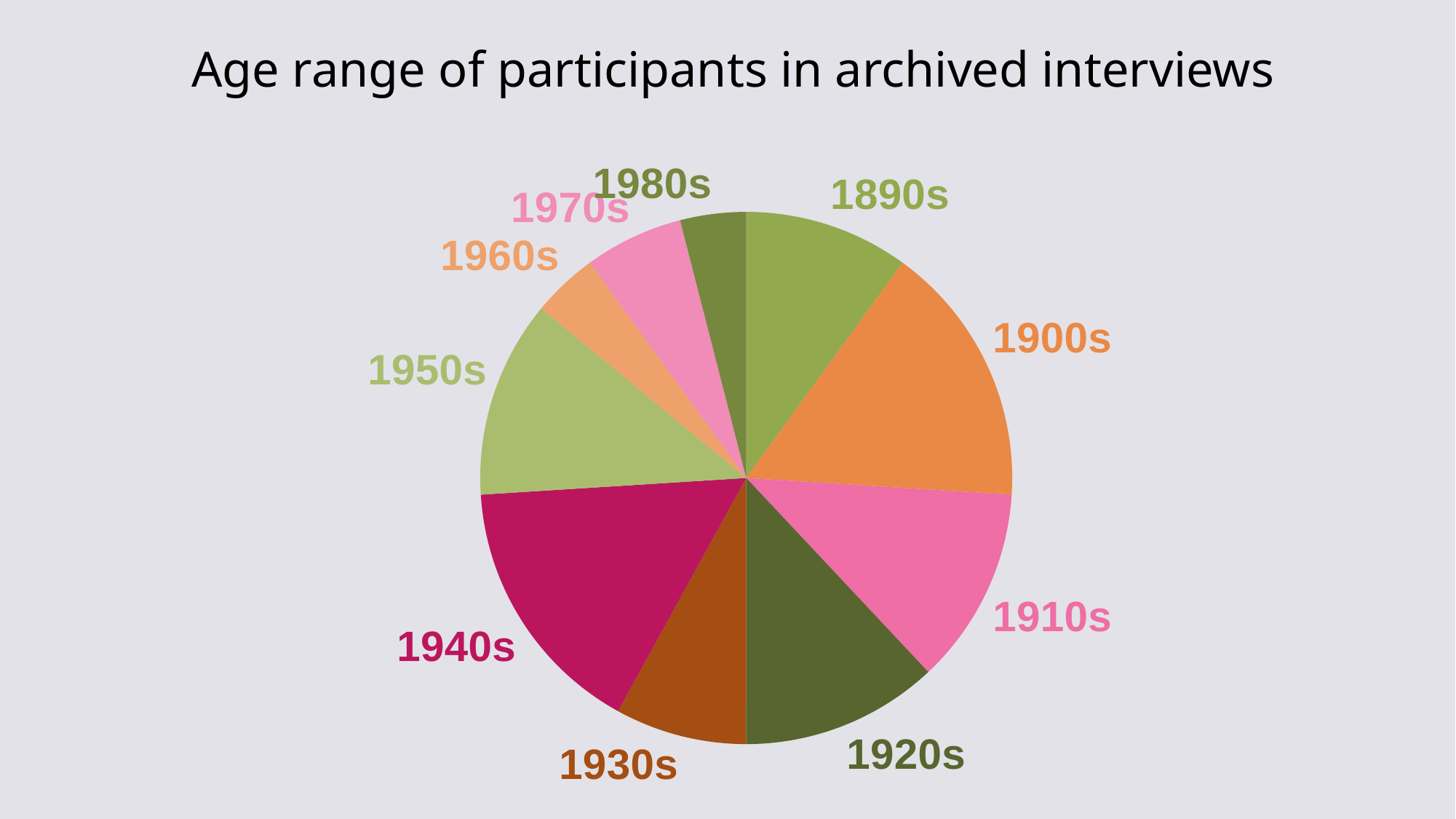
Which slice is larger, 1910s or 1970s? 1910s Which slice is larger, 1920s or 1930s? 1920s What is the title of the chart? Age range of participants in archived interviews What kind of chart is shown on the slide? Pie chart Which slice is larger, 1900s or 1980s? 1900s How many slices does the pie chart have? 10 Which decade label appears at the top of the pie, just to the right of the 1980s slice? 1890s